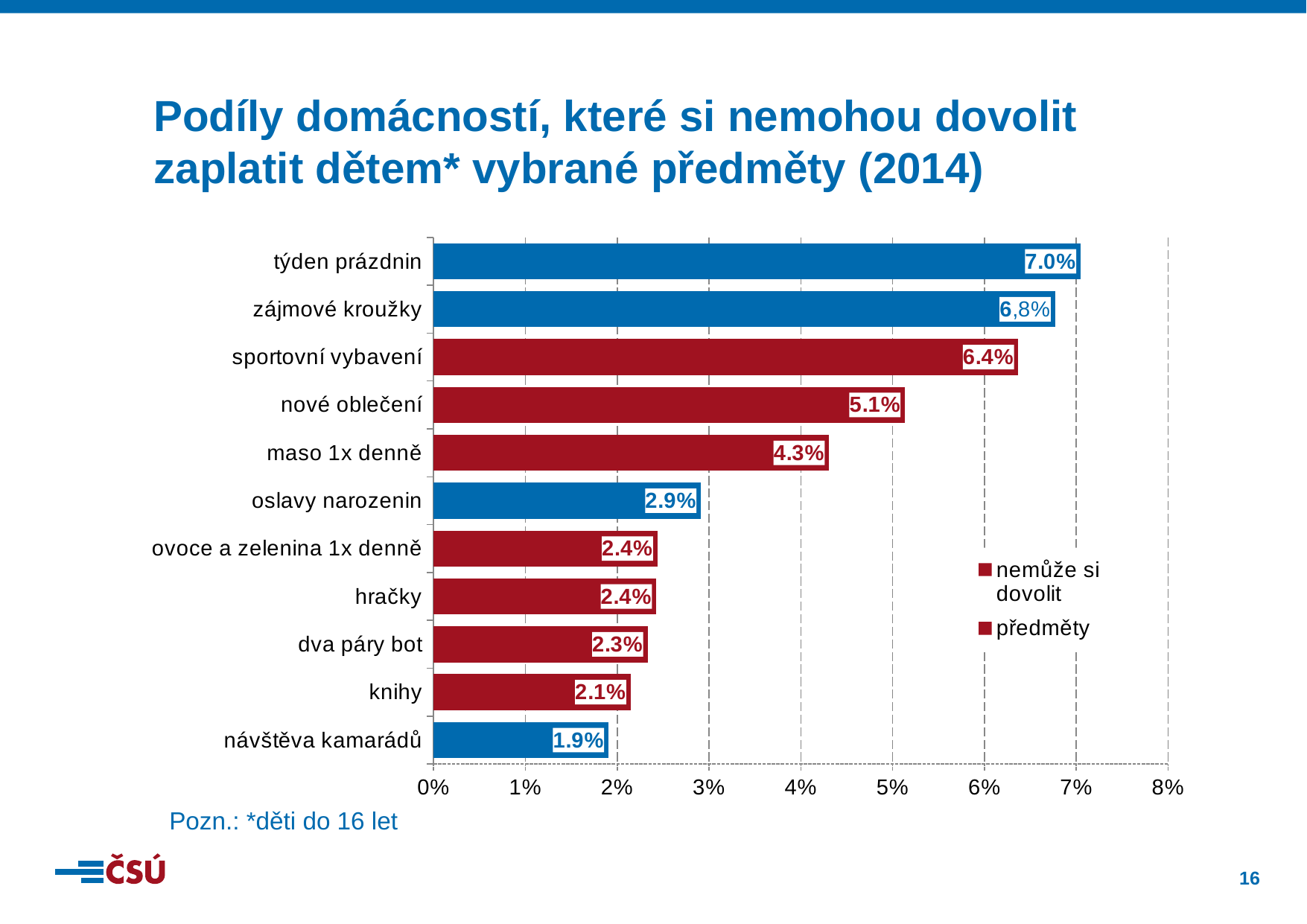
What is the value for maso 1x denně? 4.3% What is the value for týden prázdnin? 7.0% How many entries does the legend list? 2 What is the difference between the values for sportovní vybavení and nové oblečení? 1.3% Which category has the highest value? týden prázdnin Which is larger, the value for oslavy narozenin or the value for dva páry bot? oslavy narozenin Which category has the lowest value? návštěva kamarádů What is the value for návštěva kamarádů? 1.9% Is the value for nové oblečení greater or less than 5%? greater What is the value for zájmové kroužky? 6,8% How many categories are shown in the chart? 11 What kind of chart is shown on the slide? bar chart